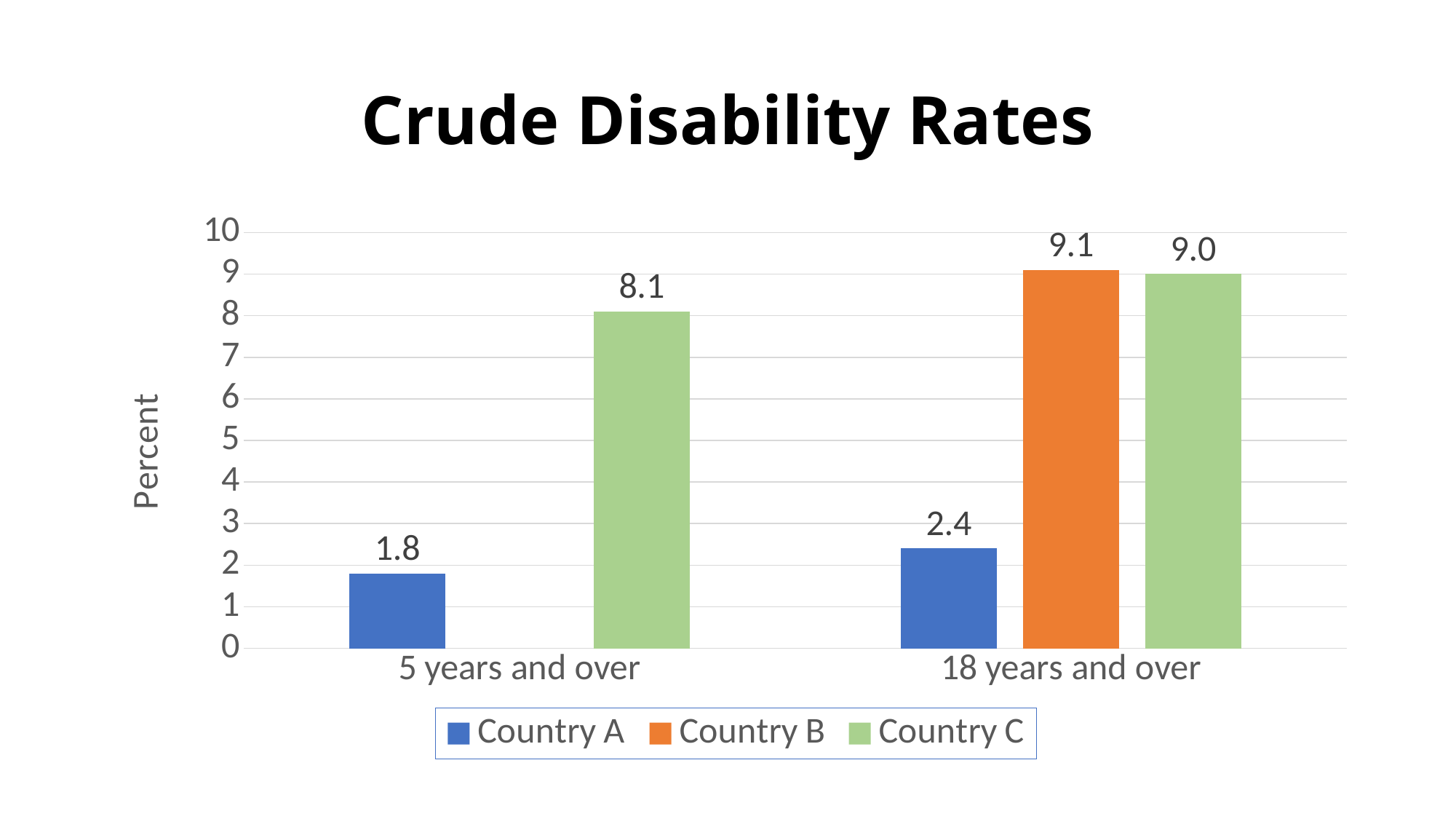
What is the difference between Country C's values for 18 years and over and 5 years and over? 0.9 What is the value for Country C in the 5 years and over category? 8.1 How many series does the legend list? 3 What is the value for Country B in the 18 years and over category? 9.1 How many categories are shown on the x axis? 2 What kind of chart is shown on the slide? Bar chart What is the title of the chart? Crude Disability Rates Which country has the lowest value in the 18 years and over category? Country A What is the value for Country A in the 5 years and over category? 1.8 What is the difference between Country C and Country A in the 5 years and over category? 6.3 Which is larger: Country A's value for 5 years and over or for 18 years and over? 18 years and over What is the value for Country A in the 18 years and over category? 2.4